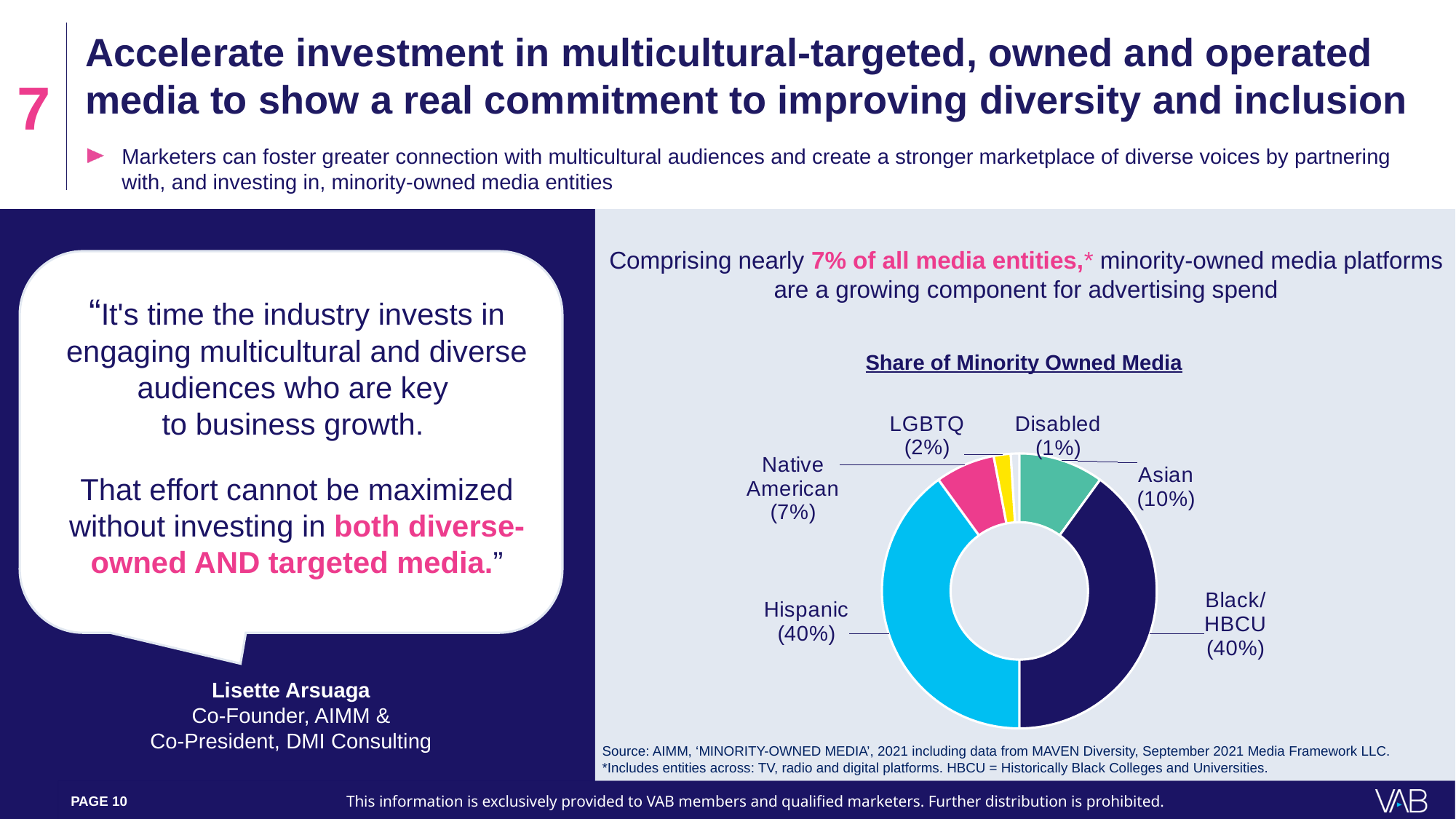
In the Share of Minority Owned Media chart, what is the difference between the Asian share and the Native American share? 3% What kind of chart is shown under the title 'Share of Minority Owned Media'? Pie chart (donut) What is the share for Asian in the Share of Minority Owned Media chart? 10% Which category has the smallest share in the Share of Minority Owned Media chart? Disabled What is the share for Native American in the Share of Minority Owned Media chart? 7% What is the share for Hispanic in the Share of Minority Owned Media chart? 40% In the Share of Minority Owned Media chart, what is the difference between the Black/HBCU share and the Disabled share? 39% In the Share of Minority Owned Media chart, which is larger: the share for Asian or the share for LGBTQ? Asian How many categories are shown in the Share of Minority Owned Media chart? 6 What is the share for LGBTQ in the Share of Minority Owned Media chart? 2% In the Share of Minority Owned Media chart, what is the combined share of Hispanic and Black/HBCU? 80% What is the title of the pie chart on the slide? Share of Minority Owned Media